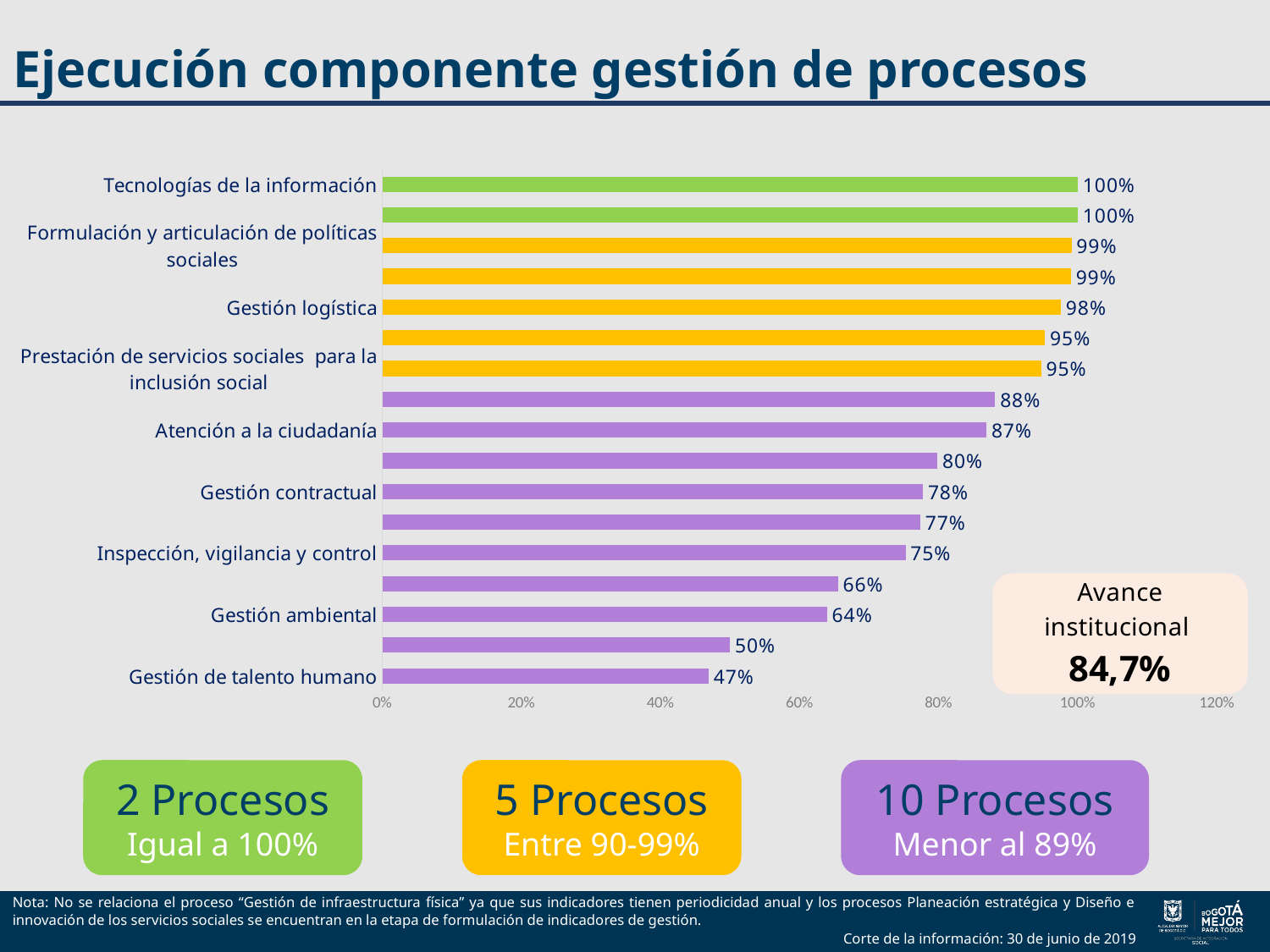
What is the value for Atención a la ciudadanía? 87% Is the value for Gestión de talento humano greater or less than 60%? less What is the value for Inspección, vigilancia y control? 75% What is the value for Gestión logística? 98% What type of chart is shown on the slide? bar chart What is the value for Tecnologías de la información? 100% What is the value for Gestión de talento humano? 47% How many bars are plotted in the chart? 17 What is the 'Avance institucional' value shown next to the chart? 84,7% What is the difference between the values for Gestión logística and Gestión ambiental? 34 percentage points Which labeled category has the lowest value? Gestión de talento humano Which is larger, the value for Atención a la ciudadanía or the value for Gestión contractual? Atención a la ciudadanía